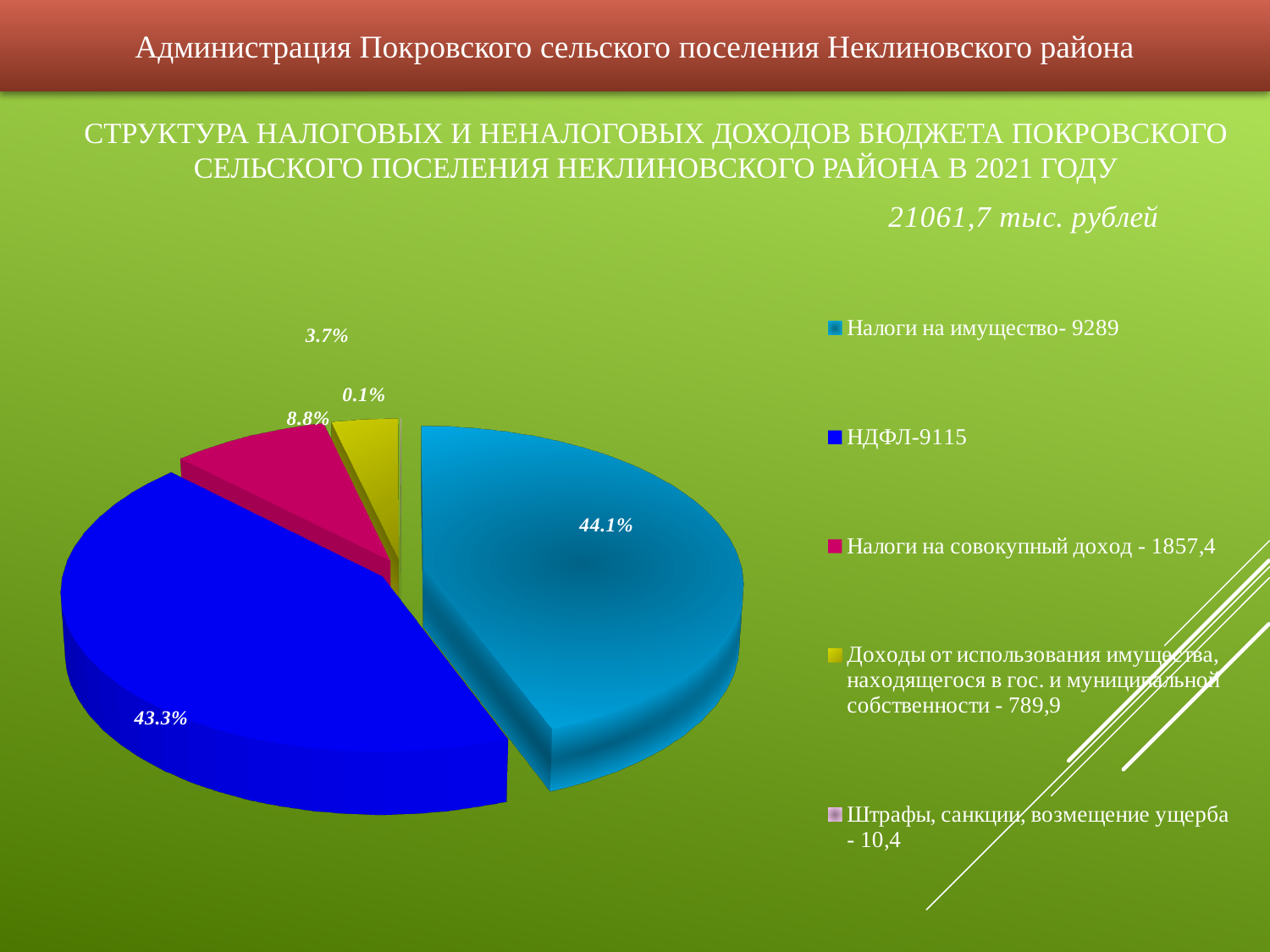
What value does the legend give for "НДФЛ"? 9115 What value does the legend give for "Налоги на совокупный доход"? 1857,4 What share of the pie does "Налоги на имущество" take? 44.1% What share of the pie does "НДФЛ" take? 43.3% Which category has the largest slice of the pie? Налоги на имущество What kind of chart is shown on the slide? pie chart What share of the pie does "Штрафы, санкции, возмещение ущерба" take? 0.1% Which category has the smallest slice of the pie? Штрафы, санкции, возмещение ущерба What total amount in thousand rubles is stated above the chart? 21061,7 тыс. рублей How many slices does the pie chart have? 5 How many entries does the legend list? 5